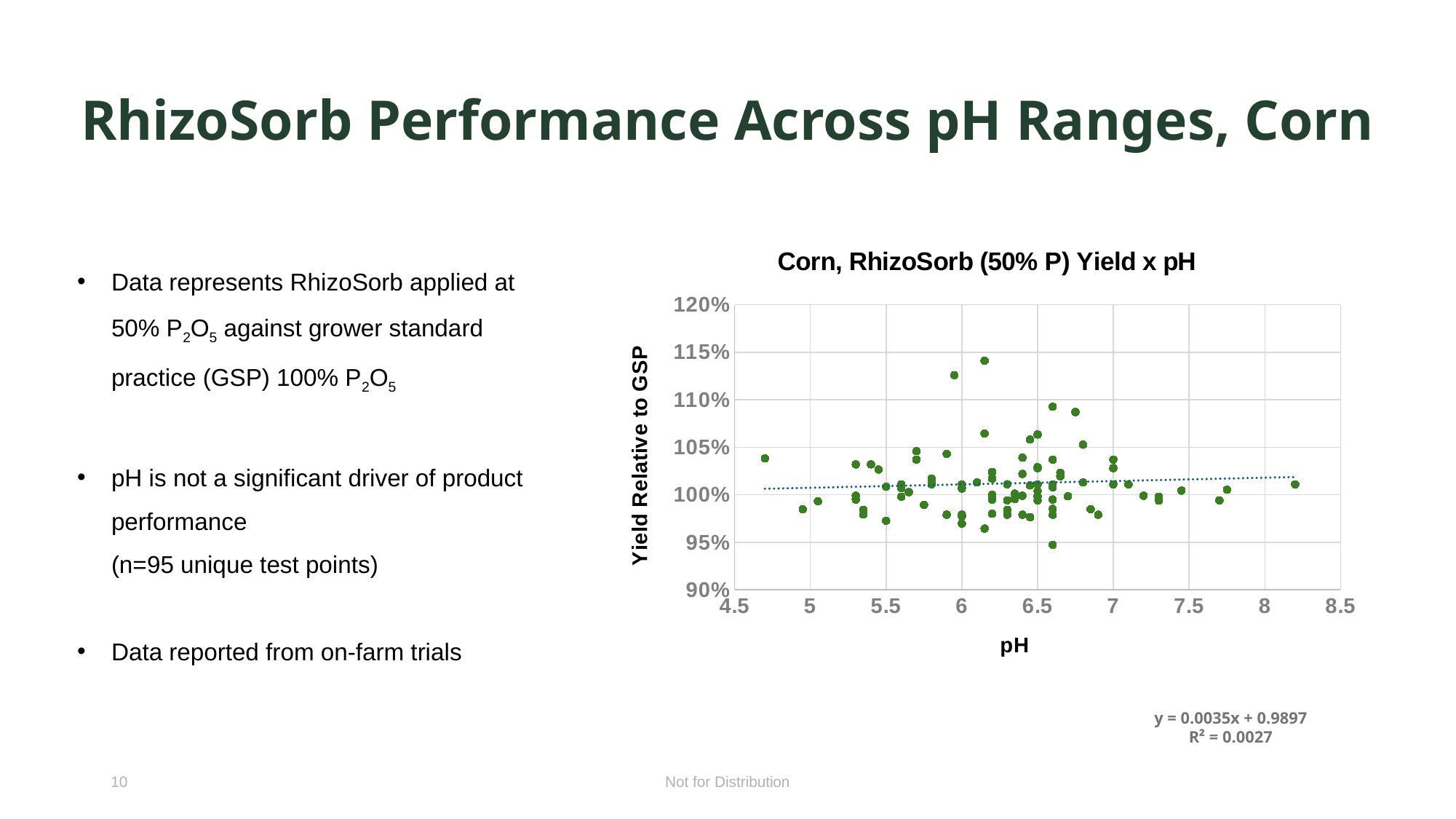
What R² value is shown for the trendline on the chart? 0.0027 Is the yield value for the point at pH 8.2 greater or less than 105%? less Is the yield value for the point at pH 4.7 greater or less than 100%? greater What is the label of the vertical axis of the chart? Yield Relative to GSP How many unique test points does the slide say are plotted in the chart? 95 What is the highest value shown on the vertical axis of the chart? 120% What kind of chart is shown on the slide? Scatter chart Is the highest plotted yield value on the chart greater or less than 110%? greater What is the trendline equation shown on the chart? y = 0.0035x + 0.9897 Does the trendline on the chart rise steeply, fall steeply, or stay nearly flat as pH increases? Nearly flat What is the title of the chart? Corn, RhizoSorb (50% P) Yield x pH